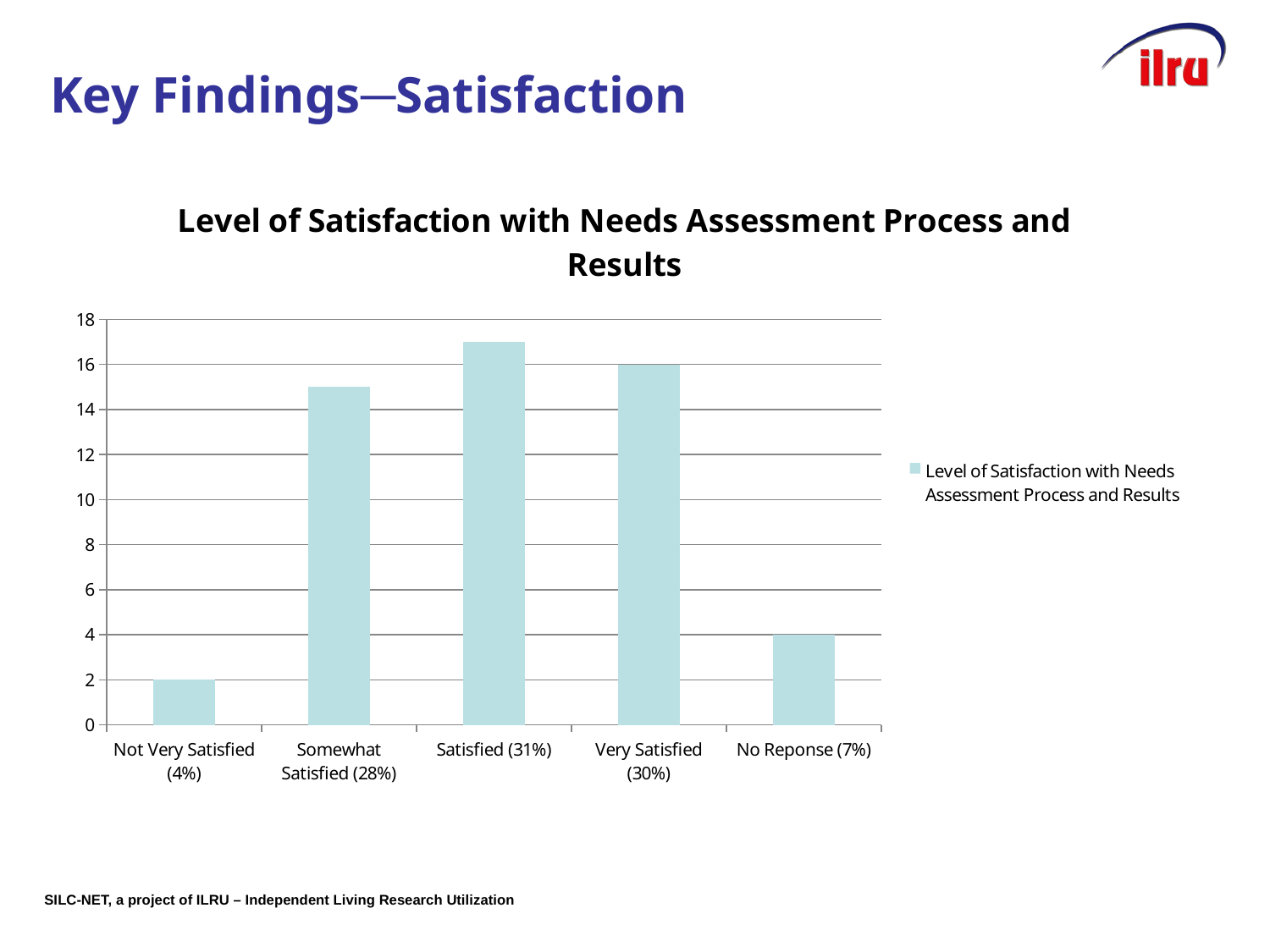
What is the title of the chart? Level of Satisfaction with Needs Assessment Process and Results What is the difference between the values for Very Satisfied (30%) and No Reponse (7%)? 12 What is the value for Very Satisfied (30%)? 16 Which category has the highest value? Satisfied (31%) Is the value for Somewhat Satisfied (28%) greater or less than 14? greater How many categories are shown on the x axis? 5 What is the value for Not Very Satisfied (4%)? 2 Which category has the lowest value? Not Very Satisfied (4%) Is the value for Satisfied (31%) greater or less than 18? less What is the value for No Reponse (7%)? 4 What kind of chart is shown on the slide? bar chart Which is larger, the value for Somewhat Satisfied (28%) or the value for No Reponse (7%)? Somewhat Satisfied (28%)